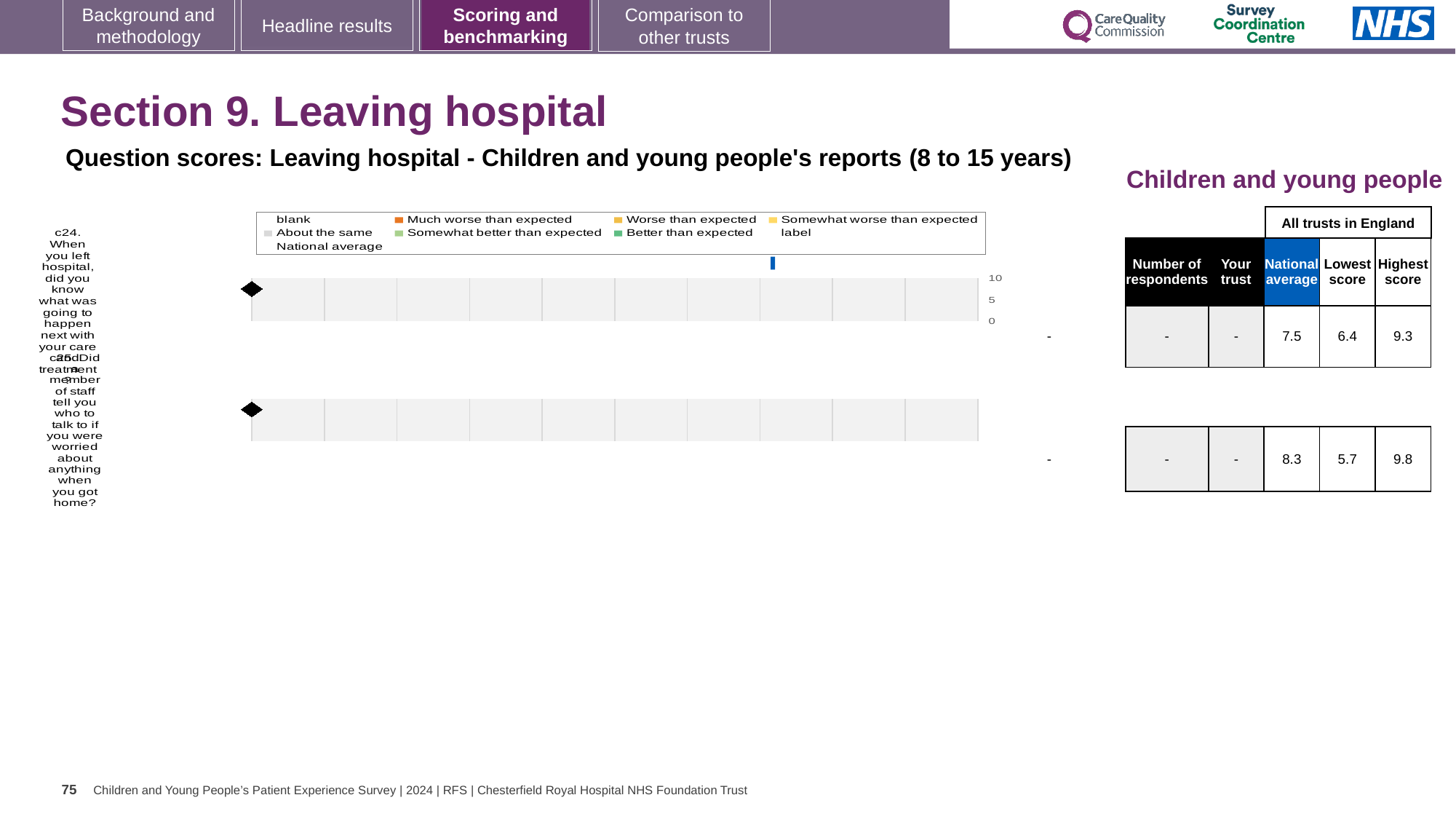
In the table beside the chart, what is the lowest score for c24? 6.4 In the table beside the chart, what is the difference between the national averages of c25 and c24? 0.8 In the table beside the chart, what is the highest score for c25? 9.8 What is the highest value shown on the chart's axis? 10 In the table beside the chart, what is the national average for c25? 8.3 Which question is plotted in the top row of the chart? c24. When you left hospital, did you know what was going to happen next with your care and treatment? In the table beside the chart, what is the national average for c24? 7.5 How many questions (categories) are plotted on the chart? 2 In the table beside the chart, what is the difference between the highest and lowest scores for c24? 2.9 In the table beside the chart, which question has the higher national average, c24 or c25? c25 What kind of chart is shown on the slide? Bar chart In the table beside the chart, what value is shown for 'Your trust' for c24? -